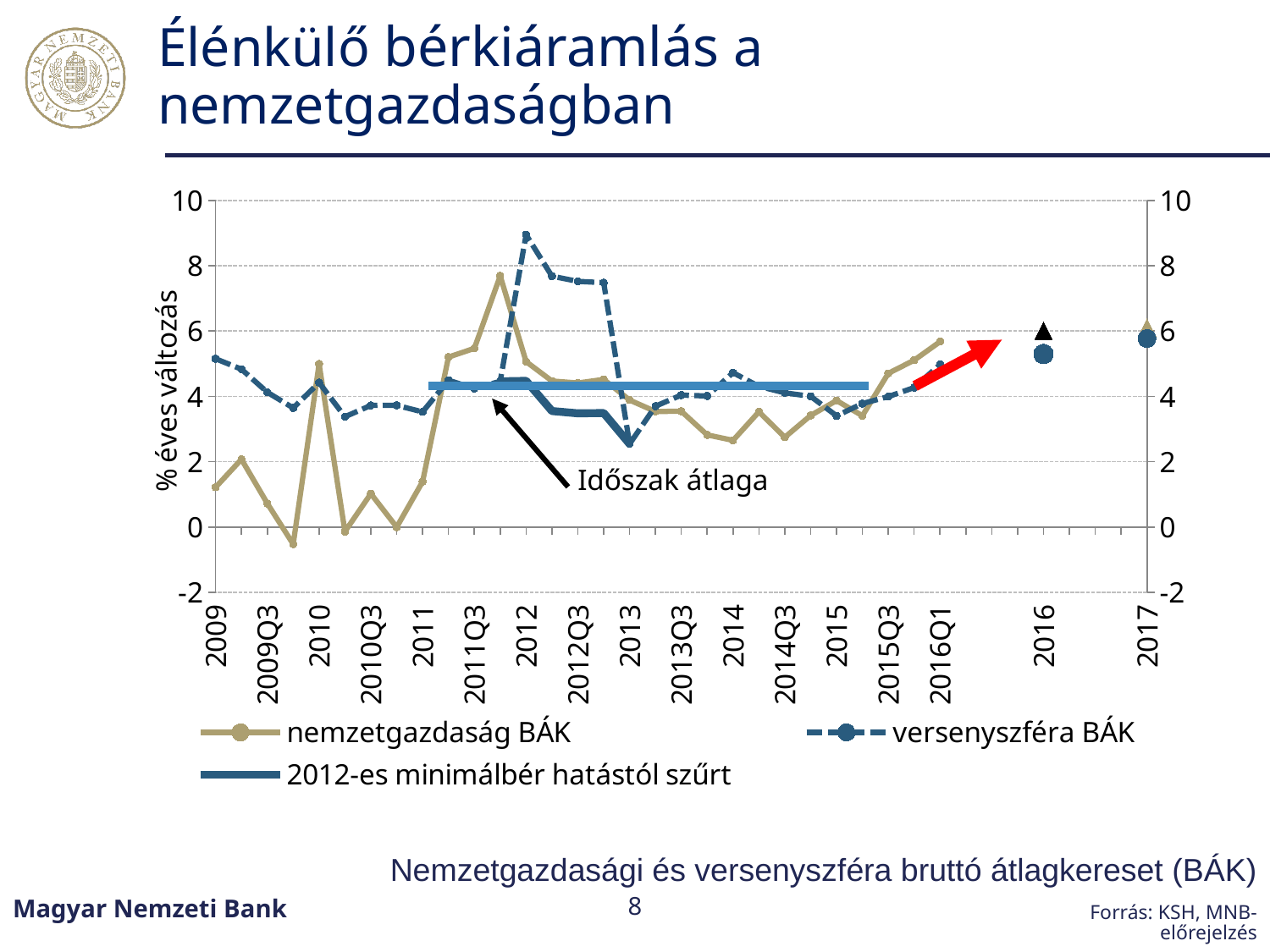
At 2011Q3, which series has the higher value: nemzetgazdaság BÁK or versenyszféra BÁK? nemzetgazdaság BÁK Is the value of nemzetgazdaság BÁK at 2009 greater or less than 2? less At 2012, which series has the higher value: nemzetgazdaság BÁK or versenyszféra BÁK? versenyszféra BÁK What does the annotation with the black arrow pointing to the horizontal blue line say? Időszak átlaga Is the value of nemzetgazdaság BÁK at 2014 greater or less than 4? less Is the value of versenyszféra BÁK at 2012 greater or less than 8? greater Which series reaches the highest value anywhere on the chart? versenyszféra BÁK What is the label on the left vertical axis of the chart? % éves változás How many series does the chart legend list? 3 What kind of chart is shown on the slide? line chart